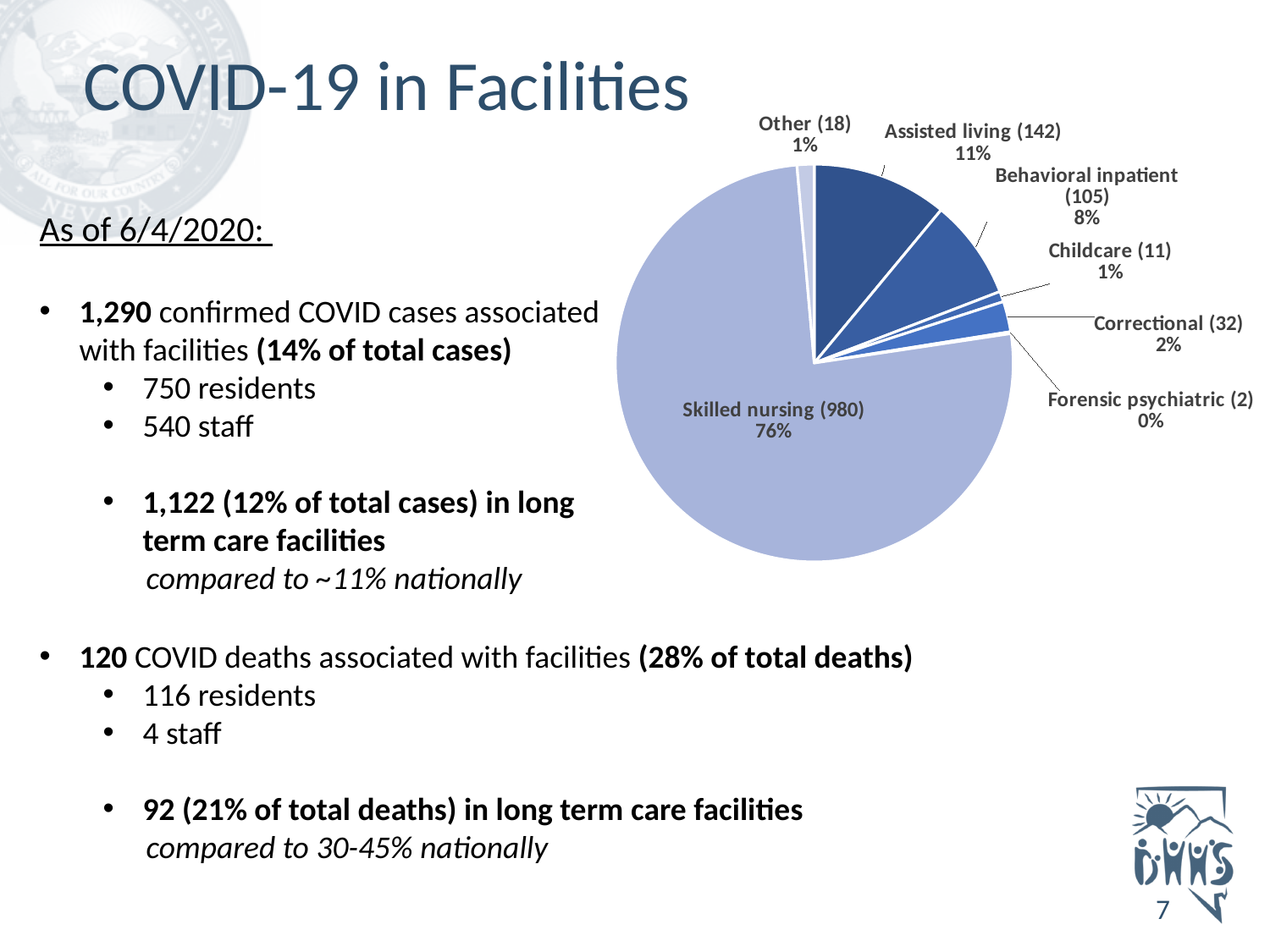
How many cases are shown for Correctional facilities? 32 Which category has the smallest slice of the pie? Forensic psychiatric How many categories does the pie chart show? 7 What share of the pie does Skilled nursing account for? 76% What percentage of the pie is Behavioral inpatient? 8% What kind of chart is shown on the slide? Pie chart How many cases are shown for Assisted living in the pie chart? 142 What percentage is shown for the Other category? 1% Which has more cases, Behavioral inpatient or Correctional? Behavioral inpatient What is the difference in cases between Skilled nursing and Assisted living? 838 Which category has the largest slice of the pie? Skilled nursing How many cases are shown for Childcare? 11